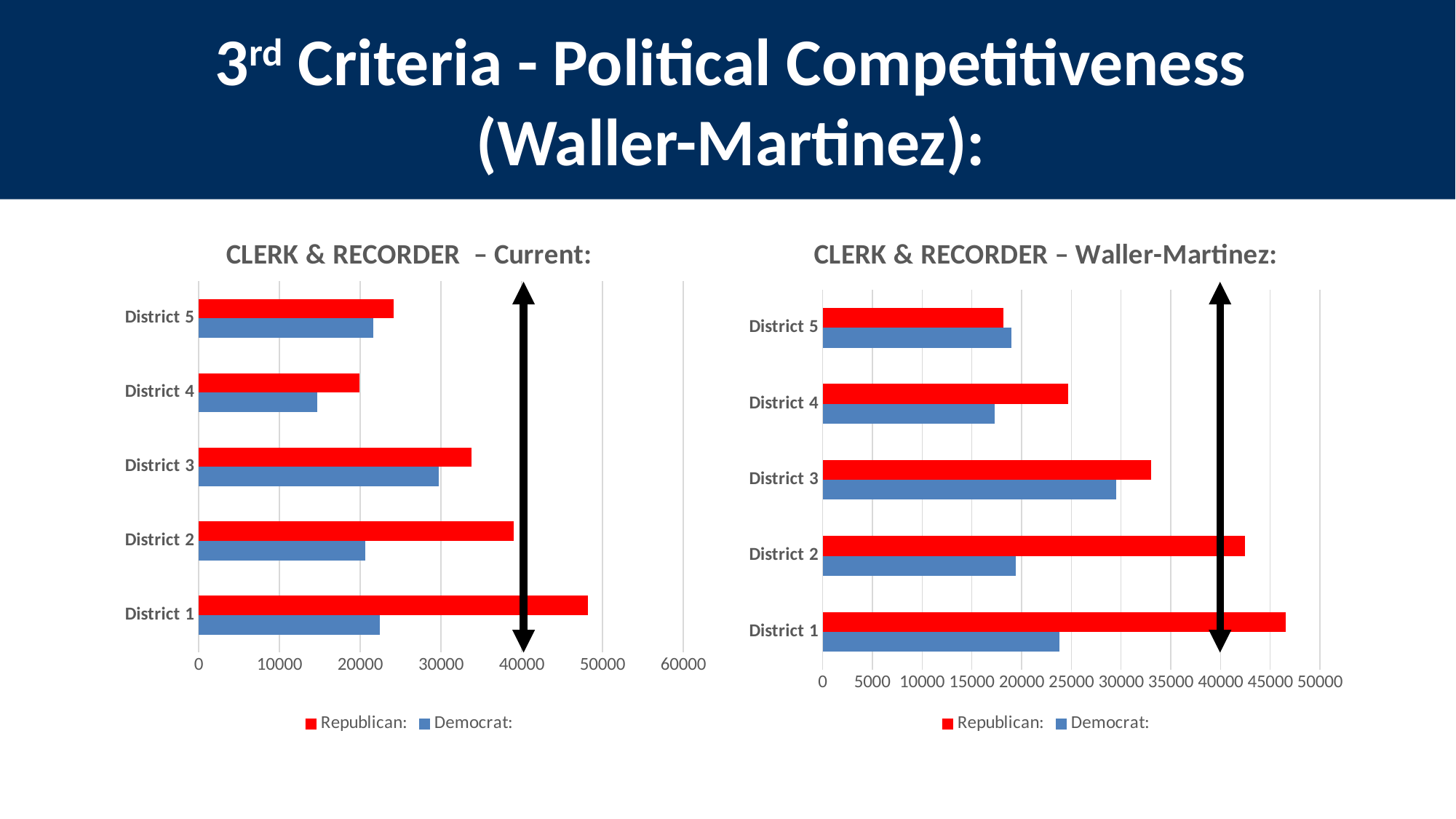
How many series does the legend of the CLERK & RECORDER – Waller-Martinez chart list? 2 In the CLERK & RECORDER – Current chart, which is larger for District 2, the Republican or the Democrat value? Republican In the CLERK & RECORDER – Current chart, is the Democrat value for District 4 greater or less than 20000? less In the CLERK & RECORDER – Waller-Martinez chart, which district has the highest Republican value? District 1 In the CLERK & RECORDER – Current chart, which district has the highest Republican value? District 1 In the CLERK & RECORDER – Waller-Martinez chart, is the Democrat value for District 3 greater or less than 25000? greater In the CLERK & RECORDER – Waller-Martinez chart, which is larger for District 4, the Republican or the Democrat value? Republican In the CLERK & RECORDER – Waller-Martinez chart, which district has the lowest Republican value? District 5 How many districts are shown in the CLERK & RECORDER – Current chart? 5 In the CLERK & RECORDER – Waller-Martinez chart, is the Republican value for District 2 greater or less than 40000? greater In the CLERK & RECORDER – Current chart, which district has the lowest Democrat value? District 4